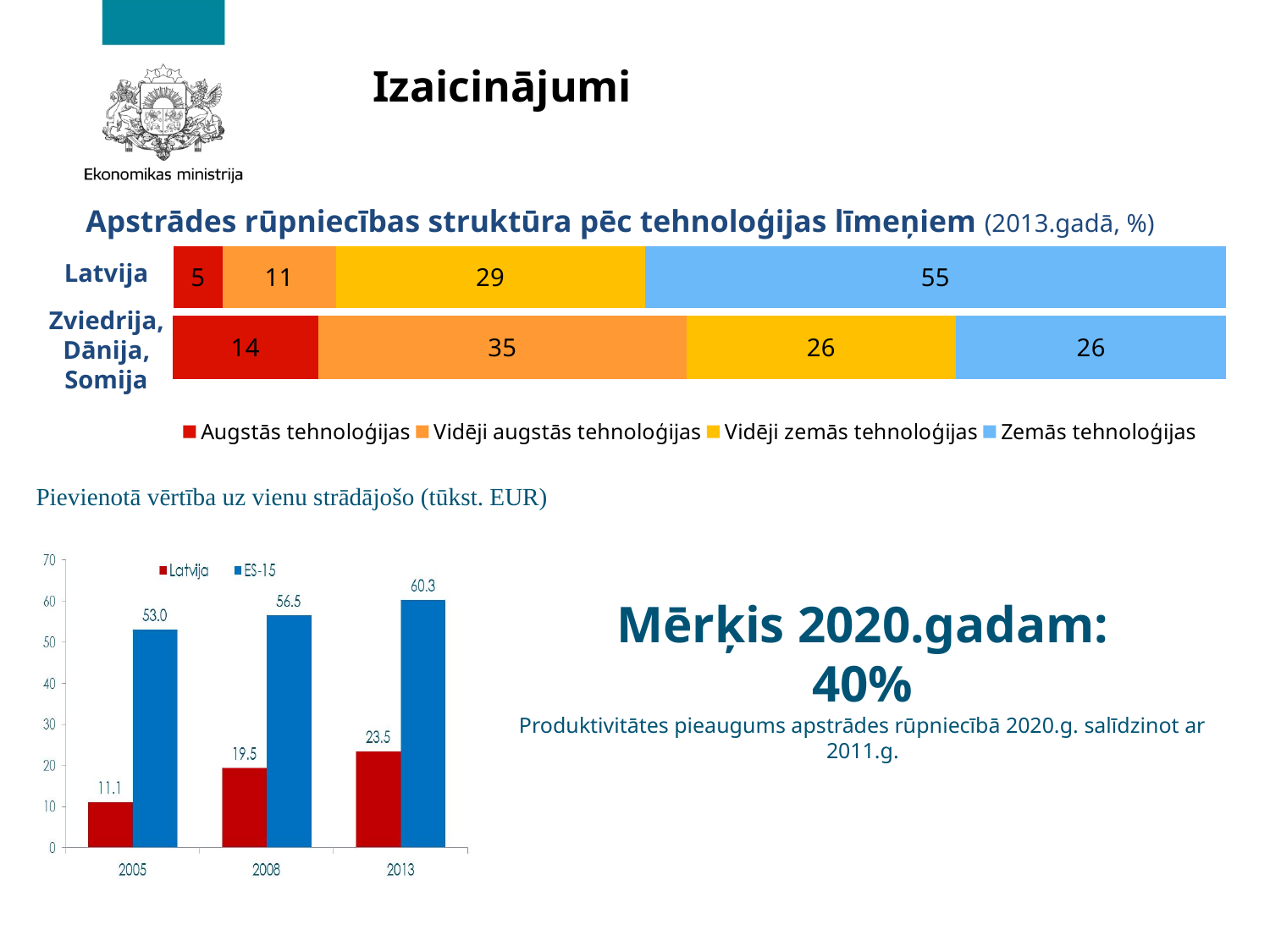
In the chart 'Apstrādes rūpniecības struktūra pēc tehnoloģijas līmeņiem', what is the value of Zemās tehnoloģijas for Latvija? 55 What kind of chart is 'Pievienotā vērtība uz vienu strādājošo (tūkst. EUR)'? bar chart In the chart 'Pievienotā vērtība uz vienu strādājošo (tūkst. EUR)', do the Latvija values rise or fall from 2005 to 2013? rise In the chart 'Apstrādes rūpniecības struktūra pēc tehnoloģijas līmeņiem', how many series does the legend list? 4 In the chart 'Pievienotā vērtība uz vienu strādājošo (tūkst. EUR)', what is the value for ES-15 in 2013? 60.3 In the chart 'Apstrādes rūpniecības struktūra pēc tehnoloģijas līmeņiem', what is the value of Vidēji augstās tehnoloģijas for Zviedrija, Dānija, Somija? 35 In the chart 'Pievienotā vērtība uz vienu strādājošo (tūkst. EUR)', how many years are shown on the x axis? 3 In the chart 'Apstrādes rūpniecības struktūra pēc tehnoloģijas līmeņiem', what is the difference between the Augstās tehnoloģijas values for Zviedrija, Dānija, Somija and Latvija? 9 In the chart 'Apstrādes rūpniecības struktūra pēc tehnoloģijas līmeņiem', which segment is the largest for Latvija? Zemās tehnoloģijas In the chart 'Apstrādes rūpniecības struktūra pēc tehnoloģijas līmeņiem', what is the total of the Latvija bar? 100 In the chart 'Pievienotā vērtība uz vienu strādājošo (tūkst. EUR)', what is the value for Latvija in 2008? 19.5 In the chart 'Pievienotā vērtība uz vienu strādājošo (tūkst. EUR)', what is the difference between ES-15 and Latvija in 2005? 41.9